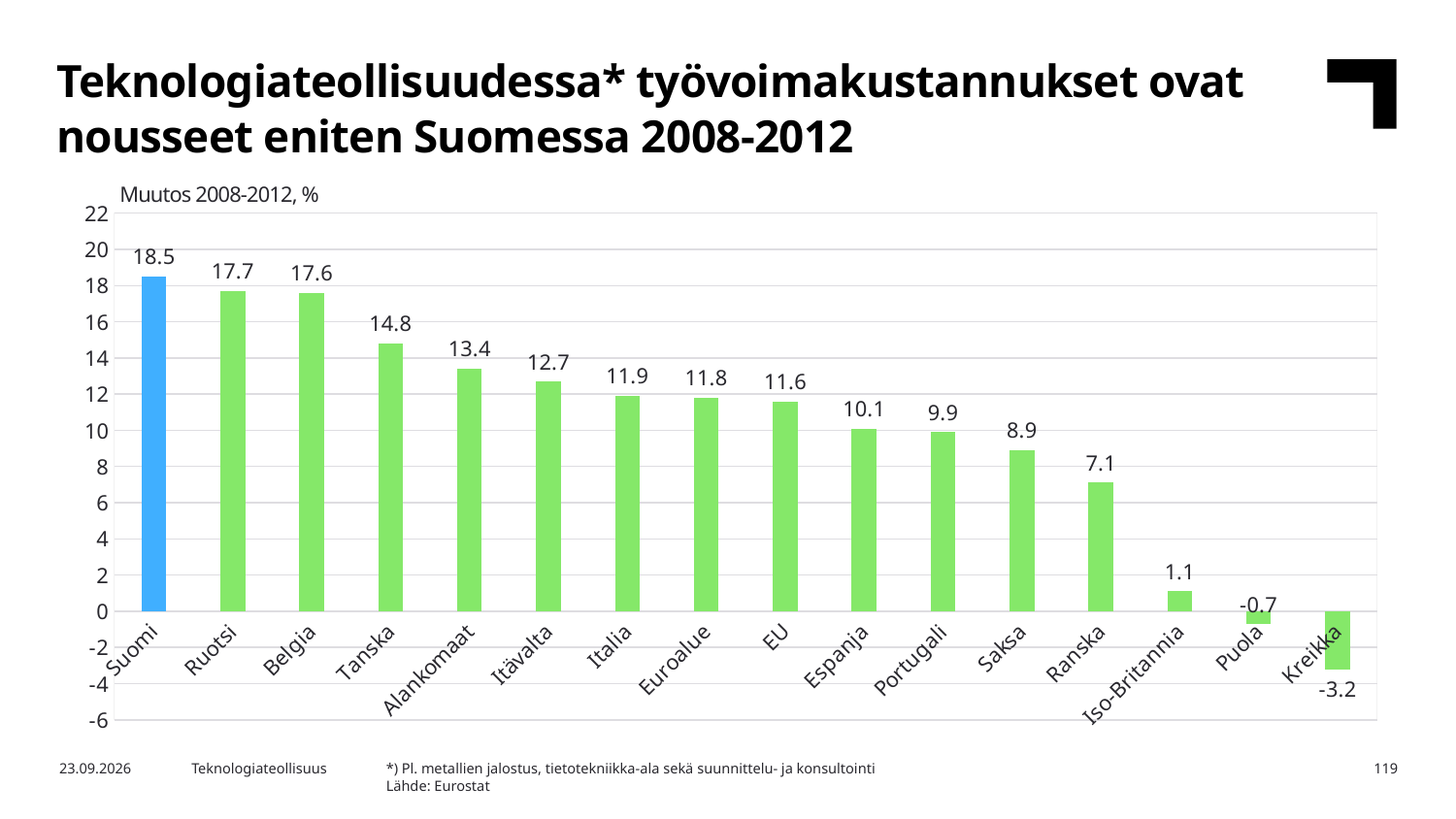
Do the values rise or fall from left to right along the x axis? Fall Which country has the highest value? Suomi What is the value for Suomi? 18.5 What is the label shown above the chart's y axis? Muutos 2008-2012, % What is the value for Alankomaat? 13.4 Which has a larger value, Tanska or Espanja? Tanska How many countries or regions are shown on the x axis? 16 What is the value for Kreikka? -3.2 What is the value for Euroalue? 11.8 What is the difference between the values for Suomi and Saksa? 9.6 Which country has the lowest value? Kreikka What kind of chart is shown on the slide? Bar chart